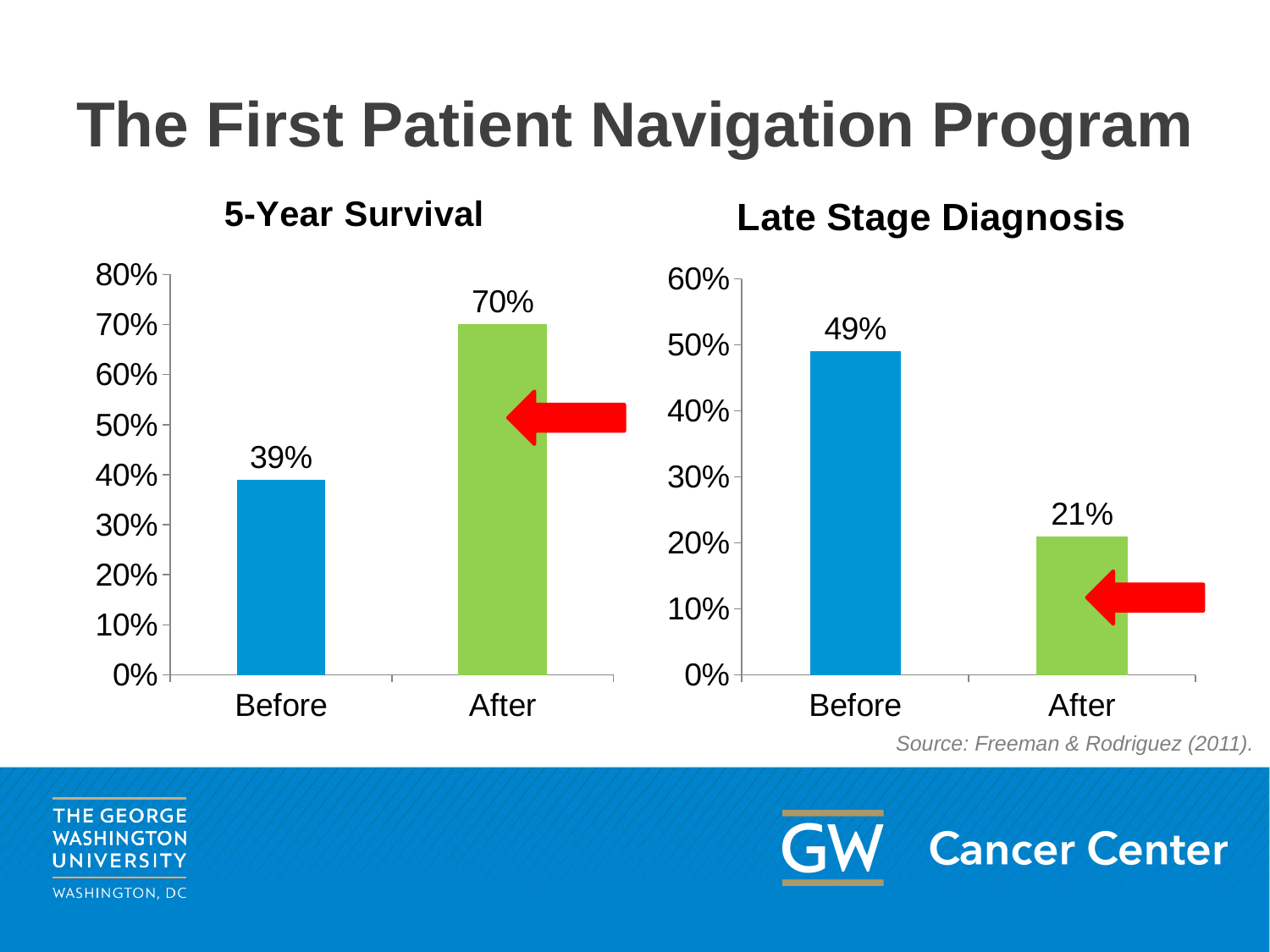
In the Late Stage Diagnosis chart, what is the difference between the Before and After values? 28% In the 5-Year Survival chart, which category has the higher value? After In the Late Stage Diagnosis chart, which category has the lower value? After What kind of chart is the Late Stage Diagnosis chart? Bar chart In the 5-Year Survival chart, what colour is the After bar? Green In the 5-Year Survival chart, what is the difference between the After and Before values? 31% In the Late Stage Diagnosis chart, is the value for Before greater or less than 40%? greater In the 5-Year Survival chart, what is the value for Before? 39% In the 5-Year Survival chart, what is the value for After? 70% In the Late Stage Diagnosis chart, what is the value for After? 21% How many categories are shown in the 5-Year Survival chart? 2 In the Late Stage Diagnosis chart, what is the value for Before? 49%